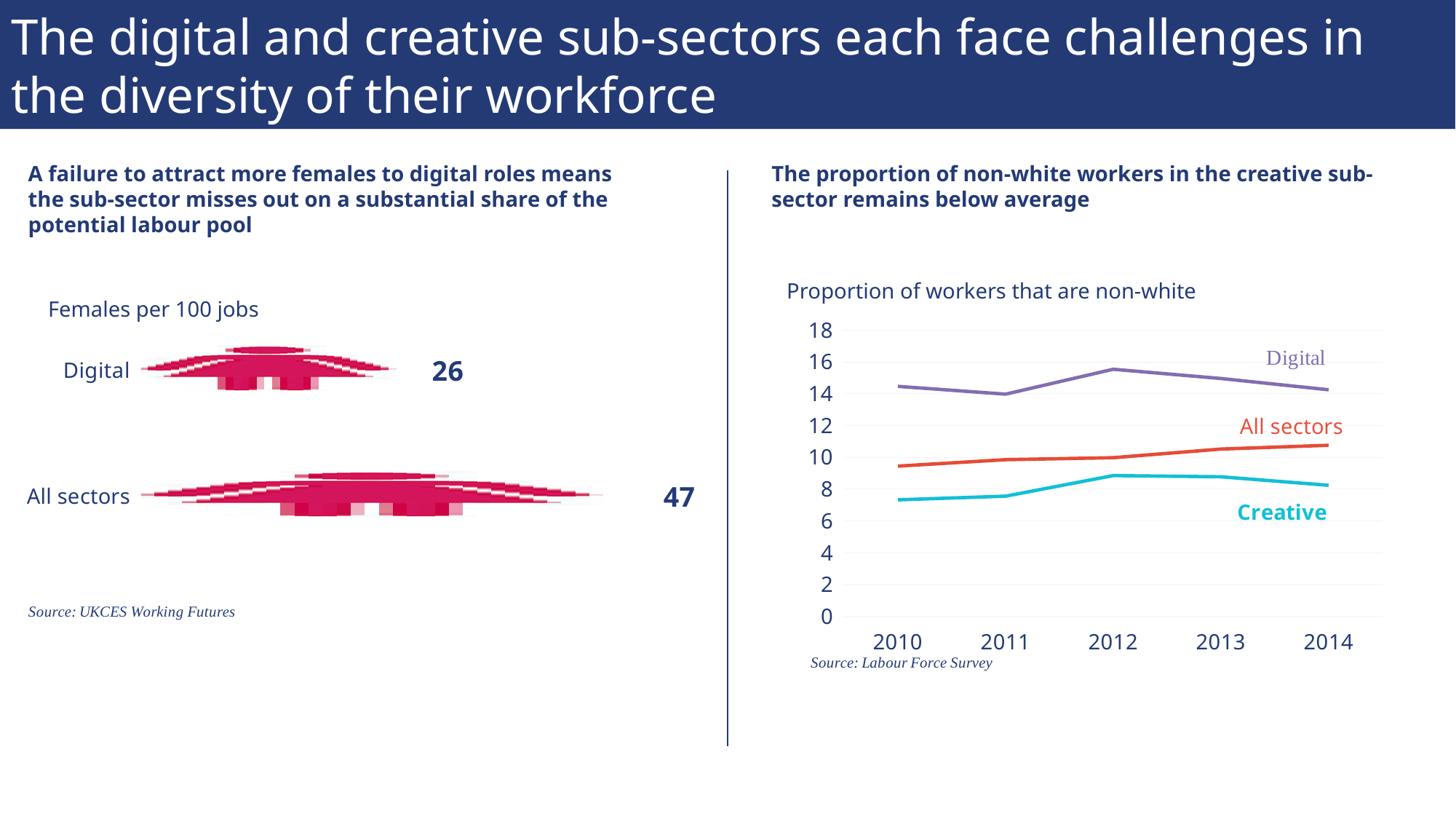
In the 'Females per 100 jobs' chart, what is the value for Digital? 26 What kind of chart is 'Proportion of workers that are non-white'? Line chart How many years are shown on the x axis of the 'Proportion of workers that are non-white' chart? 5 In the 'Proportion of workers that are non-white' chart, which series has the highest value in 2014? Digital In the 'Proportion of workers that are non-white' chart, which series has the lowest value in 2010? Creative In the 'Females per 100 jobs' chart, what is the value for All sectors? 47 How many categories are shown in the 'Females per 100 jobs' chart? 2 In the 'Proportion of workers that are non-white' chart, is the value for Digital in 2012 greater or less than 14? greater In the 'Females per 100 jobs' chart, what is the difference between All sectors and Digital? 21 In the 'Females per 100 jobs' chart, which has the higher value, Digital or All sectors? All sectors In the 'Proportion of workers that are non-white' chart, does the All sectors line rise or fall from 2010 to 2014? Rise How many series are plotted in the 'Proportion of workers that are non-white' chart? 3